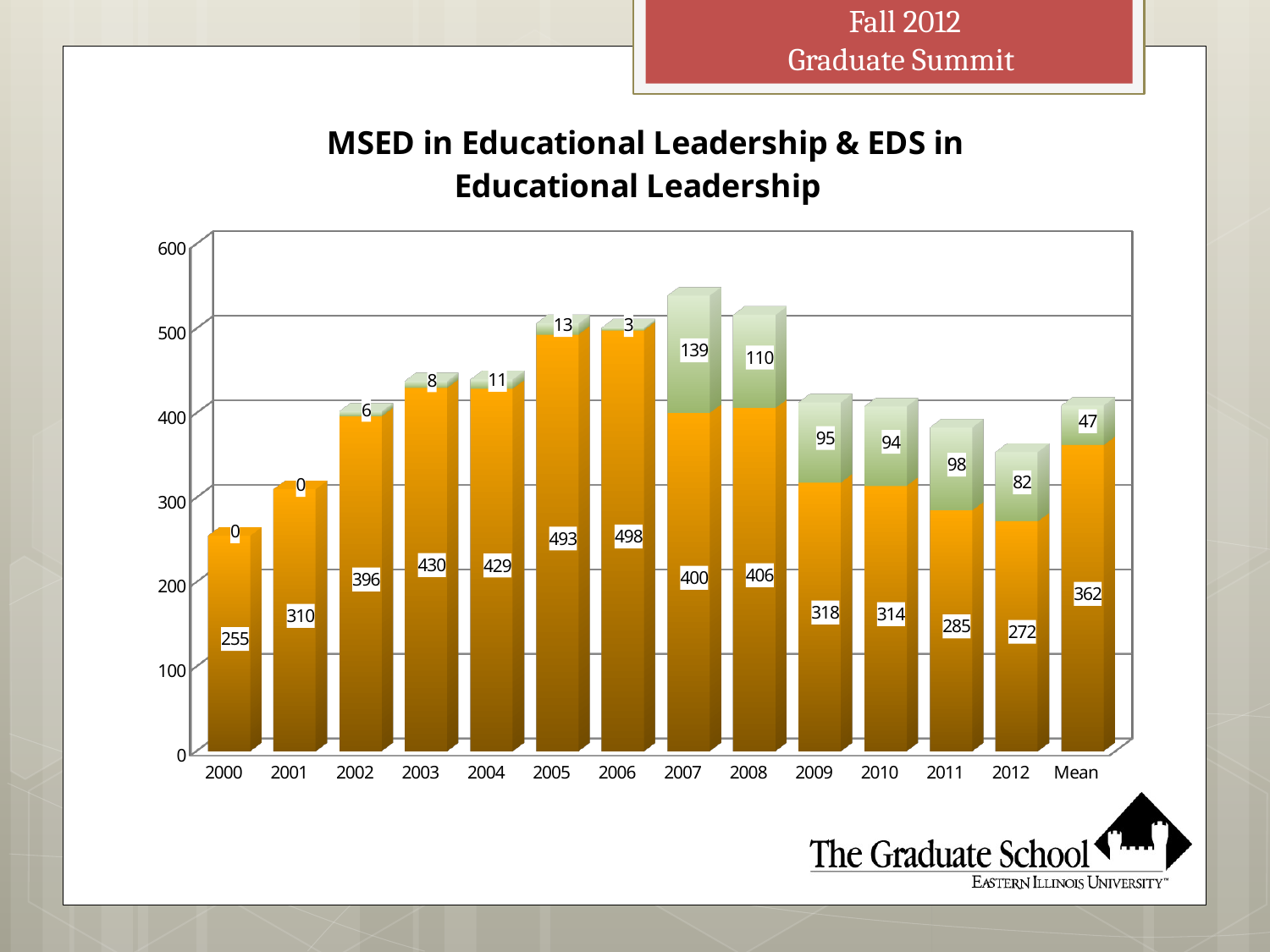
What is the difference between the orange segment values for 2006 and 2000? 243 What is the value of the orange (lower) segment for the Mean bar? 362 Is the total height of the 2012 bar greater or less than 300? greater Which year has the smallest orange (lower) segment? 2000 Which is larger, the orange segment for 2008 or for 2009? 2008 Which year has the largest green (upper) segment? 2007 What kind of chart is shown on the slide? Stacked bar chart How many categories are shown on the x axis? 14 What is the total of the stacked bar for 2007? 539 What is the value of the green (upper) segment for 2007? 139 Does the orange (lower) segment rise or fall from 2000 to 2006? Rises What is the value of the orange (lower) segment for 2003? 430